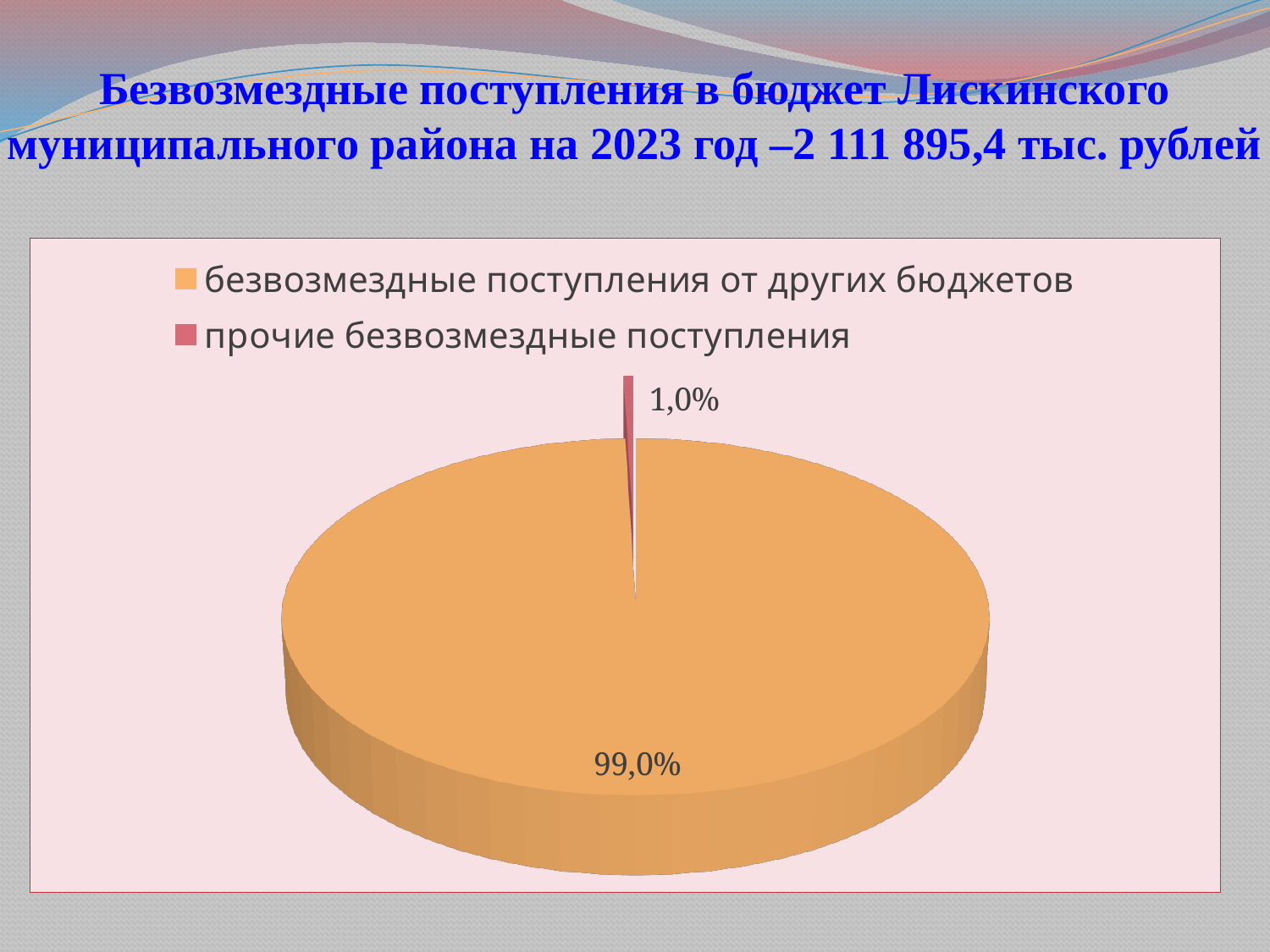
What total amount of gratuitous receipts for 2023 is stated in the slide title? 2 111 895,4 тыс. рублей Which category has the largest slice of the pie? безвозмездные поступления от других бюджетов What colour is the slice for "прочие безвозмездные поступления"? red How many slices does the pie chart have? 2 How many entries does the legend list? 2 What share of the pie does "безвозмездные поступления от других бюджетов" take? 99,0% What kind of chart is shown on the slide? pie chart Which category has the smallest slice of the pie? прочие безвозмездные поступления Which is larger: the slice for "безвозмездные поступления от других бюджетов" or the slice for "прочие безвозмездные поступления"? безвозмездные поступления от других бюджетов What share of the pie does "прочие безвозмездные поступления" take? 1,0% What is the difference in percentage points between the two slices of the pie? 98,0%